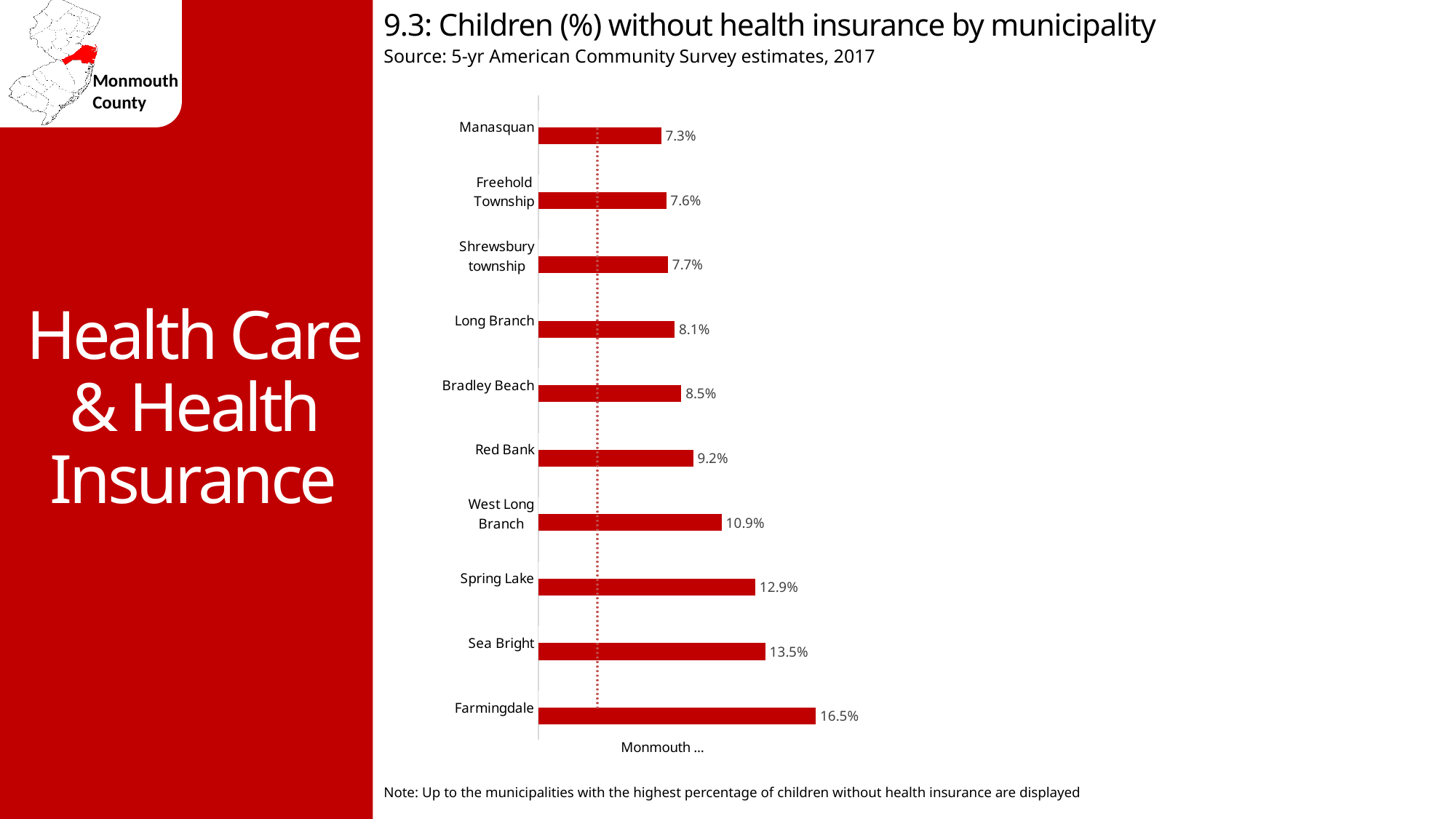
What is the title of the chart? 9.3: Children (%) without health insurance by municipality What is the value shown for West Long Branch? 10.9% What kind of chart is shown on the slide? Bar chart What percentage of children in Farmingdale are without health insurance? 16.5% Which municipality has the highest percentage of children without health insurance? Farmingdale Which has a higher value, Spring Lake or Red Bank? Spring Lake What is the difference between the values for Farmingdale and Manasquan? 9.2% What is the difference between the values for Sea Bright and Spring Lake? 0.6% Which municipality has the lowest percentage of children without health insurance? Manasquan How many municipalities are shown in the chart? 10 Which has a higher value, Bradley Beach or Long Branch? Bradley Beach What is the value shown for Red Bank? 9.2%